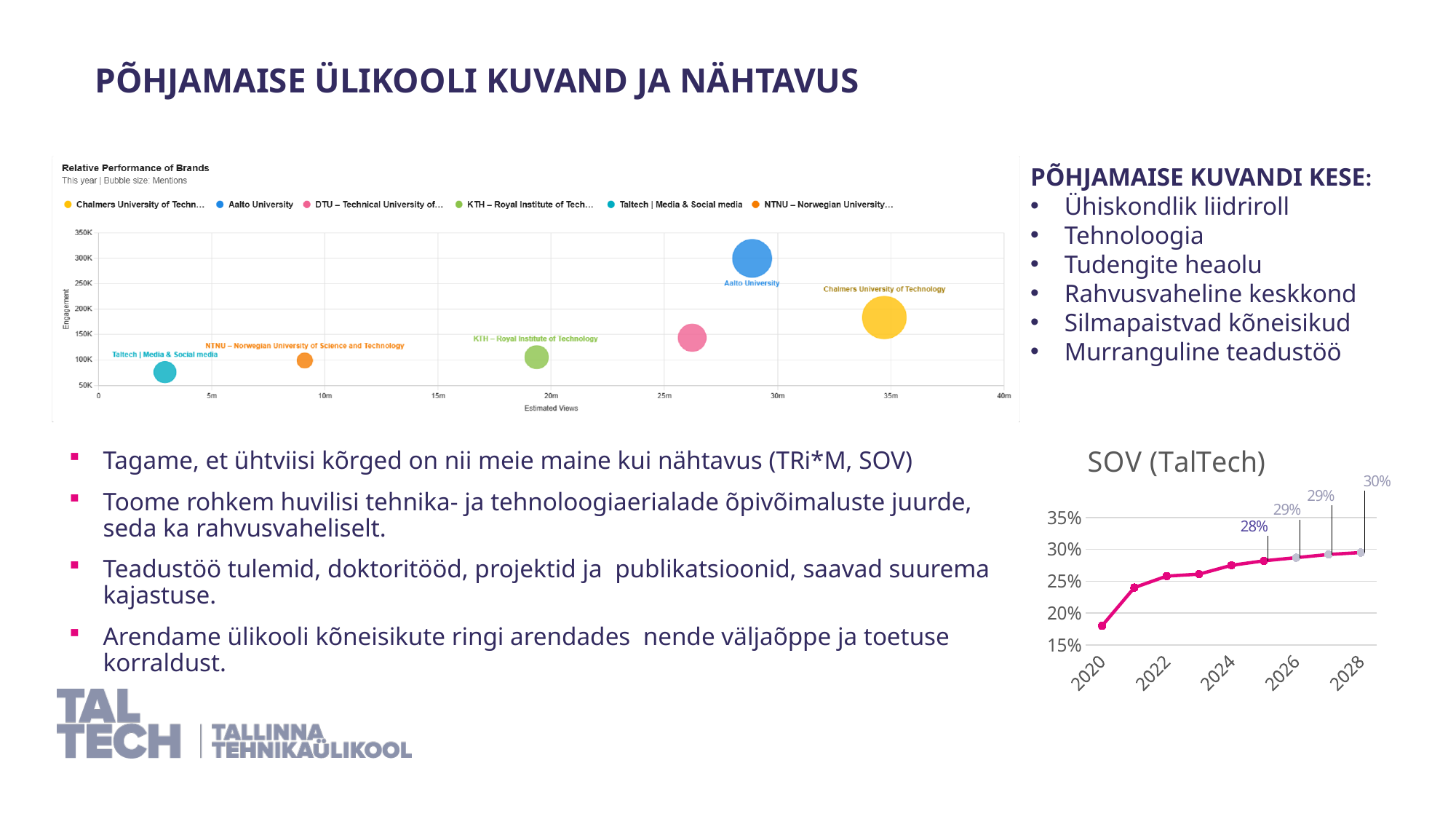
In the 'SOV (TalTech)' chart, what is the difference between the 2028 value and the 2025 value? 2% In the 'SOV (TalTech)' chart, what is the value for 2025? 28% How many series does the legend of the 'Relative Performance of Brands' chart list? 6 What kind of chart is the 'SOV (TalTech)' chart? Line chart In the 'Relative Performance of Brands' chart, is the engagement for Aalto University greater or less than 250K? greater In the 'Relative Performance of Brands' chart, which brand has the lowest estimated views? Taltech | Media & Social media In the 'SOV (TalTech)' chart, do the values rise or fall from 2020 to 2028? Rise In the 'Relative Performance of Brands' chart, which university has the highest engagement? Aalto University In the 'SOV (TalTech)' chart, is the value for 2020 greater or less than 20%? less In the 'Relative Performance of Brands' chart, which has more estimated views, Chalmers University of Technology or KTH – Royal Institute of Technology? Chalmers University of Technology What kind of chart is the 'Relative Performance of Brands' chart? Bubble chart In the 'SOV (TalTech)' chart, what is the value for 2028? 30%